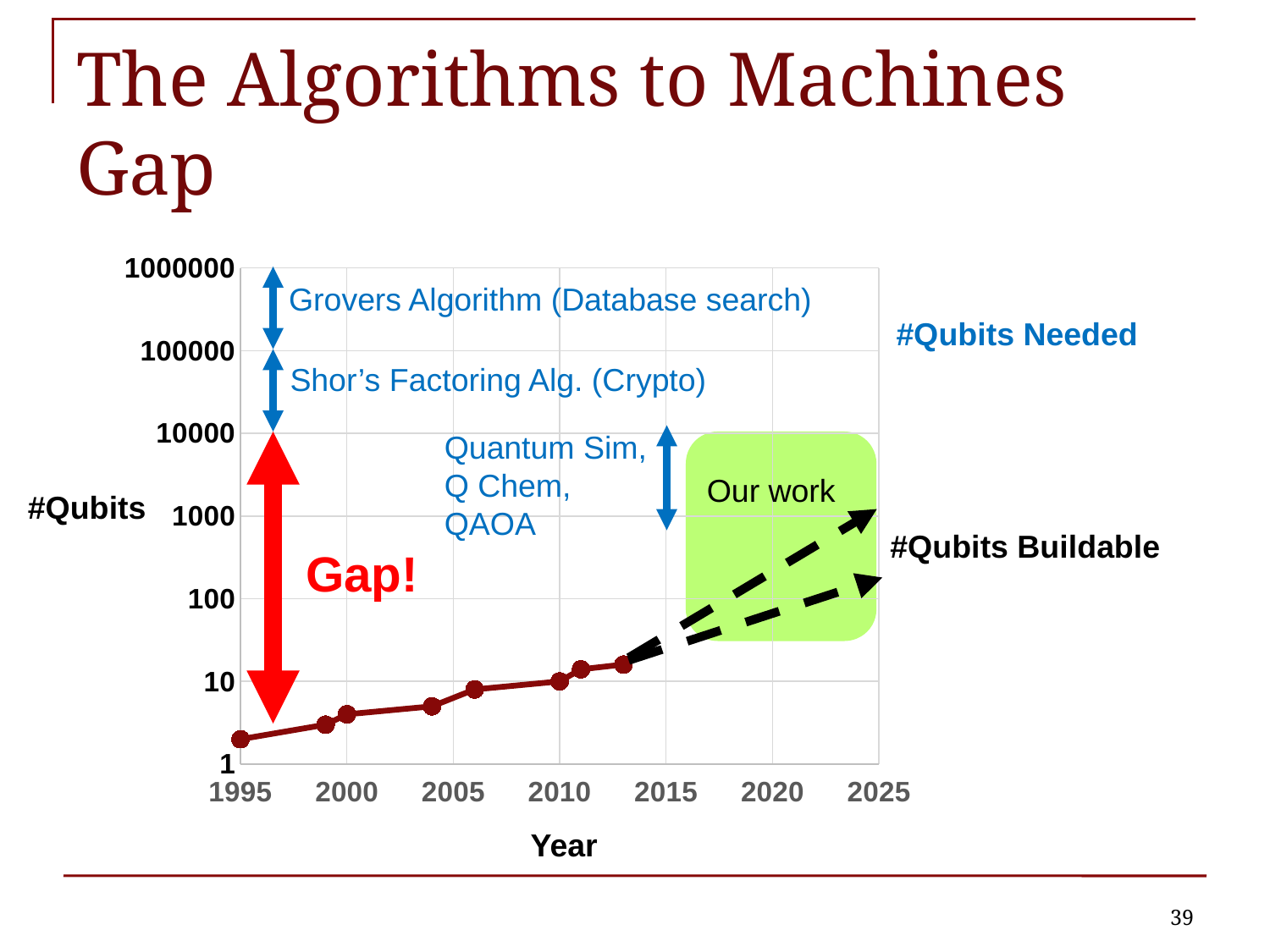
Do the plotted #Qubits values rise or fall as the year increases from 1995 to 2013? rise Which has the larger plotted value, 2000 or 2010? 2010 Is the plotted value for 2013 greater or less than 10? greater Which plotted year has the highest #Qubits value? 2013 What kind of chart is shown on the slide? line chart How many data points are plotted on the line? 8 What is the label on the x axis? Year What is the highest tick value shown on the y axis? 1000000 Is the plotted value for 1995 greater or less than 10? less Is the plotted value for 2013 greater or less than 100? less Which plotted year has the lowest #Qubits value? 1995